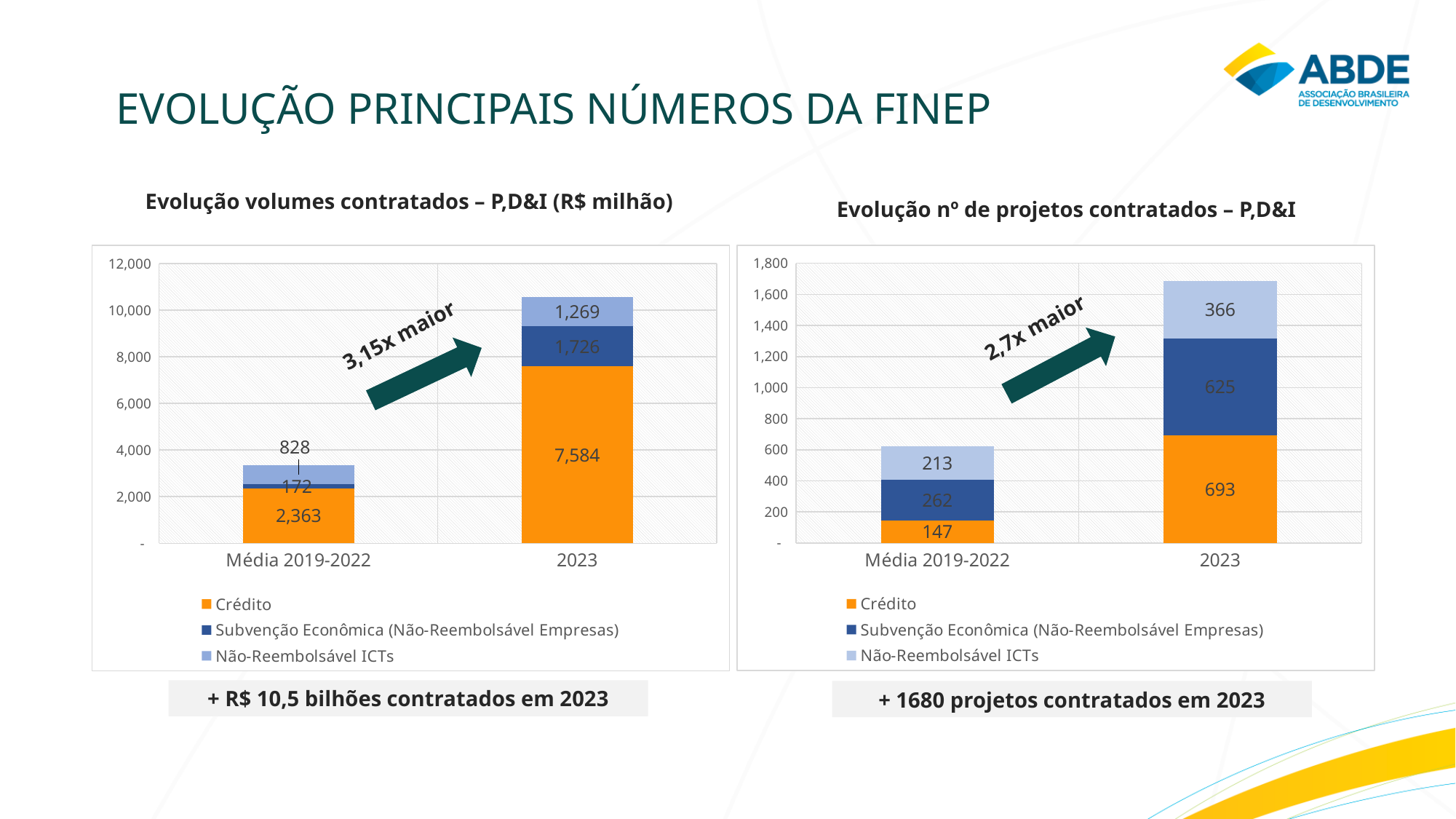
How many series does the legend of the chart 'Evolução volumes contratados – P,D&I (R$ milhão)' list? 3 In the chart 'Evolução nº de projetos contratados – P,D&I', what is the Não-Reembolsável ICTs value for 2023? 366 In the chart 'Evolução nº de projetos contratados – P,D&I', which is larger for 2023: Subvenção Econômica or Não-Reembolsável ICTs? Subvenção Econômica In the chart 'Evolução nº de projetos contratados – P,D&I', what is the total of the stacked bar for Média 2019-2022? 622 In the chart 'Evolução volumes contratados – P,D&I (R$ milhão)', what is the total of the stacked bar for 2023? 10,579 In the chart 'Evolução nº de projetos contratados – P,D&I', which category has the highest Crédito value? 2023 How many categories are shown on the x axis of the chart 'Evolução volumes contratados – P,D&I (R$ milhão)'? 2 In the chart 'Evolução volumes contratados – P,D&I (R$ milhão)', what is the Crédito value for 2023? 7,584 In the chart 'Evolução volumes contratados – P,D&I (R$ milhão)', what is the Subvenção Econômica value for Média 2019-2022? 172 In the chart 'Evolução volumes contratados – P,D&I (R$ milhão)', what is the difference between the Crédito values for 2023 and Média 2019-2022? 5,221 What kind of chart is 'Evolução nº de projetos contratados – P,D&I'? Stacked bar chart In the chart 'Evolução nº de projetos contratados – P,D&I', what is the Crédito value for Média 2019-2022? 147